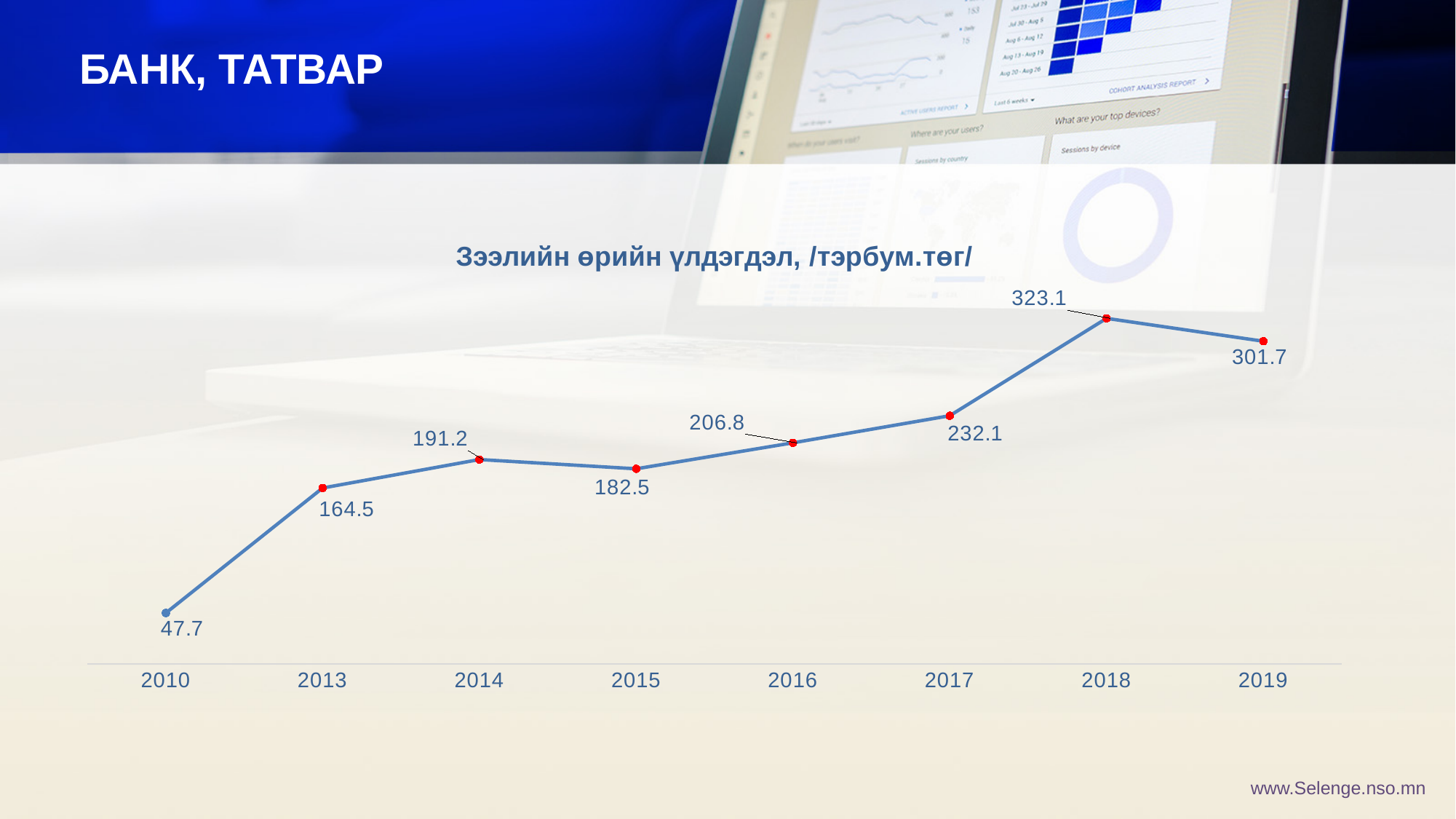
Does the value rise or fall from 2017 to 2018? rise Which year has the lowest value? 2010 What is the value for 2010? 47.7 What is the value for 2019? 301.7 Which year has the highest value? 2018 What is the title of the chart? Зээлийн өрийн үлдэгдэл, /тэрбум.төг/ What is the value for 2016? 206.8 What is the difference between the values for 2014 and 2015? 8.7 How many years are plotted on the chart? 8 What is the difference between the values for 2018 and 2019? 21.4 What kind of chart is shown on the slide? line chart Which is larger, the value for 2014 or the value for 2015? 2014